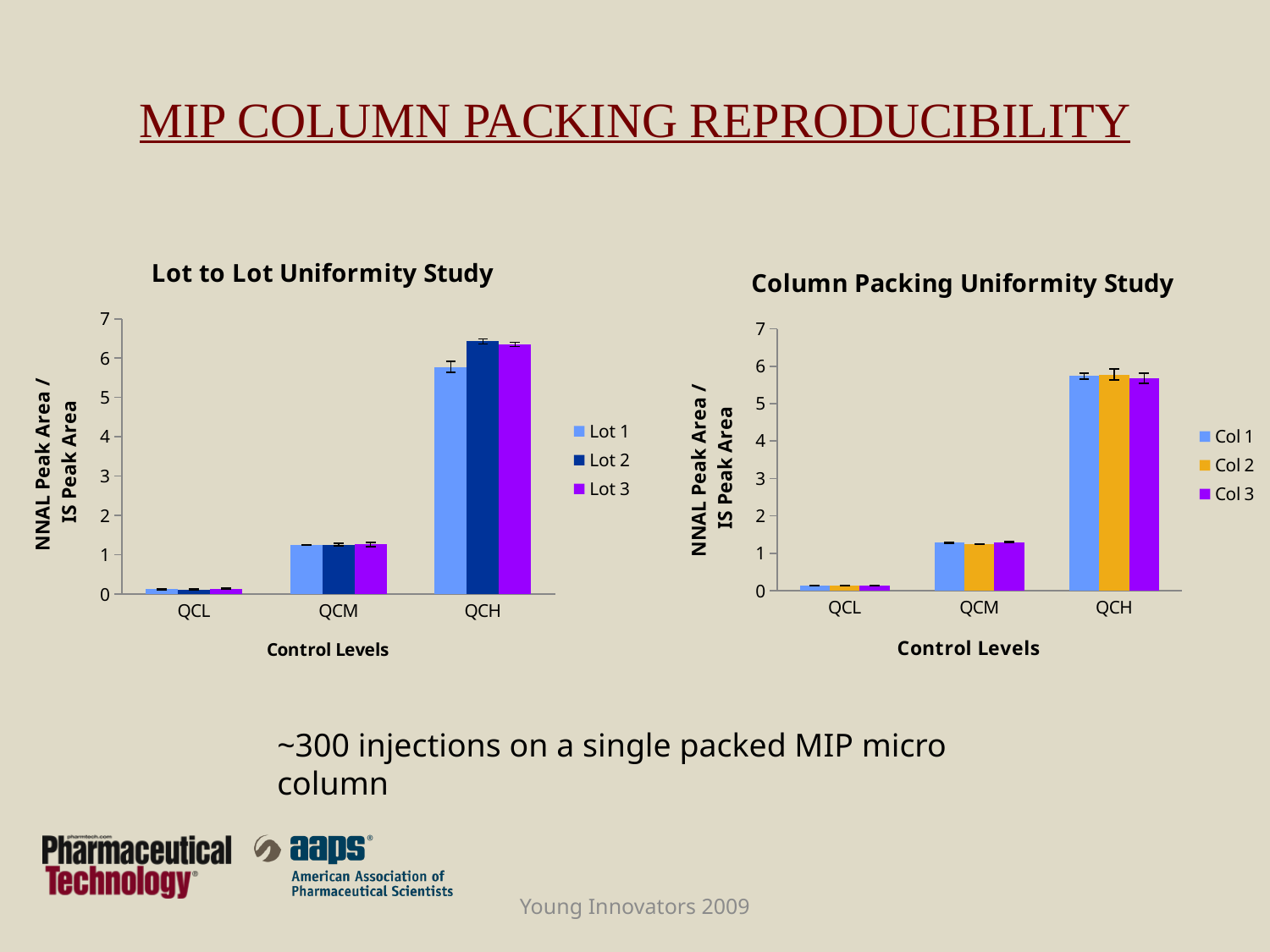
In the 'Column Packing Uniformity Study' chart, do the values rise or fall from QCL to QCH? rise In the 'Column Packing Uniformity Study' chart, is the value for Col 1 at QCH greater or less than 5? greater What kind of chart is the 'Lot to Lot Uniformity Study' chart? bar chart How many control levels are shown on the x axis of the 'Column Packing Uniformity Study' chart? 3 How many series does the legend of the 'Lot to Lot Uniformity Study' chart list? 3 In the 'Lot to Lot Uniformity Study' chart, which is larger at QCH: Lot 1 or Lot 2? Lot 2 What is the x-axis title of the 'Column Packing Uniformity Study' chart? Control Levels In the 'Column Packing Uniformity Study' chart, which control level has the lowest values? QCL In the 'Lot to Lot Uniformity Study' chart, which control level has the highest values? QCH In the 'Column Packing Uniformity Study' chart, is the value for Col 2 at QCM greater or less than 2? less In the 'Lot to Lot Uniformity Study' chart, is the value for Lot 2 at QCH greater or less than 6? greater